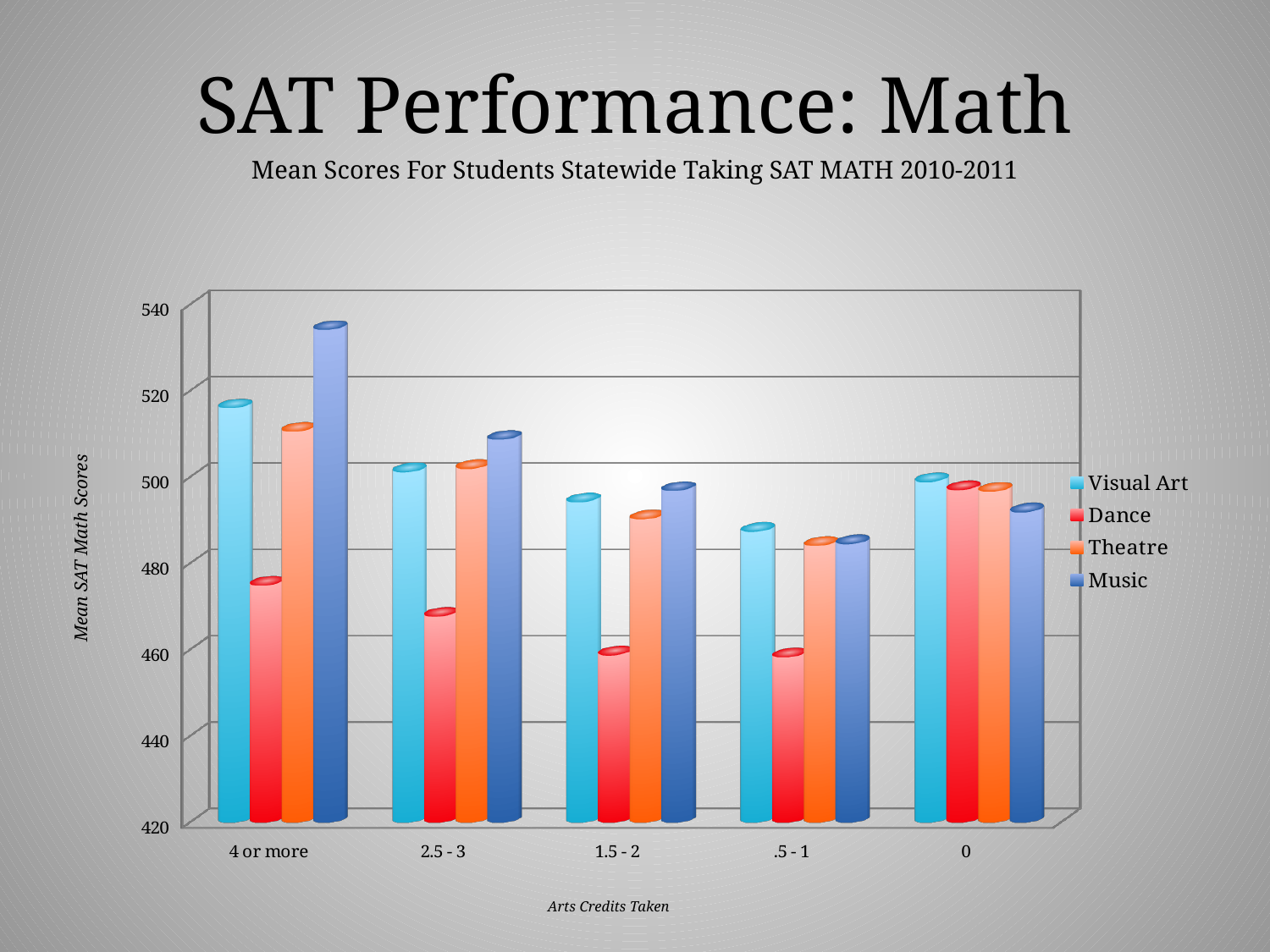
How many series does the legend list? 4 What kind of chart is shown on the slide? bar chart What is the title of the x axis? Arts Credits Taken Do the Music values rise or fall from '4 or more' to '.5 - 1'? fall Which series has the highest bar in the '4 or more' category? Music Is the Dance value for '2.5 - 3' greater or less than 480? less Which series has the lowest bar in the '4 or more' category? Dance Is the Dance value for '4 or more' greater or less than 480? less Is the Music value for '2.5 - 3' greater or less than 500? greater Which is larger for '1.5 - 2': the Visual Art value or the Dance value? Visual Art How many categories of arts credits are shown on the x axis? 5